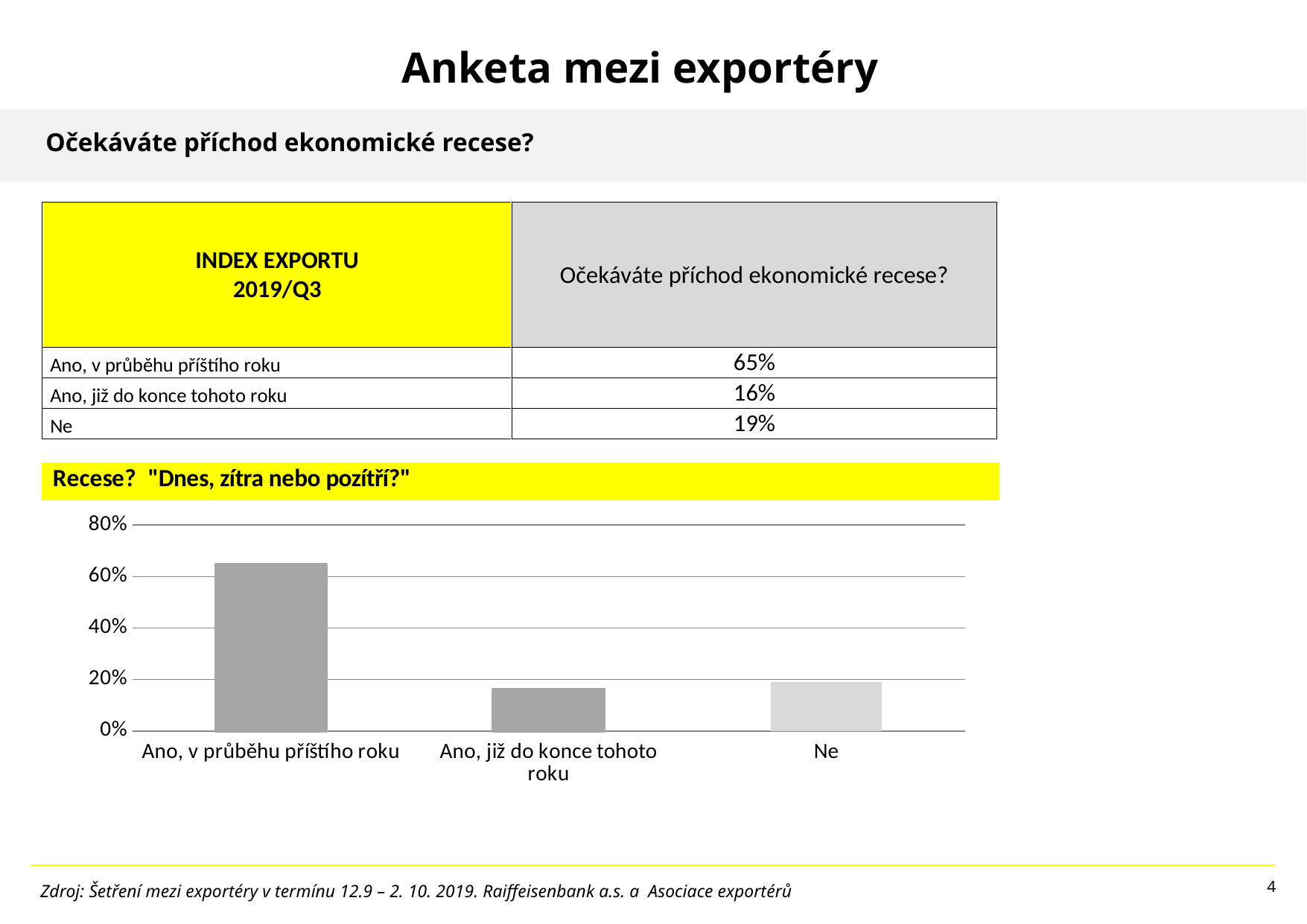
What is the value for "Ne"? 19% What is the difference between the values for "Ano, v průběhu příštího roku" and "Ne"? 46% Which category has the lowest bar in the chart? Ano, již do konce tohoto roku Which category has the highest bar in the chart? Ano, v průběhu příštího roku Is the bar for "Ano, v průběhu příštího roku" greater or less than 60%? greater What is the value for "Ano, v průběhu příštího roku"? 65% What is the value for "Ano, již do konce tohoto roku"? 16% Which is larger, the value for "Ne" or the value for "Ano, již do konce tohoto roku"? Ne How many categories are shown on the x axis of the bar chart? 3 What is the title of the bar chart? Recese? "Dnes, zítra nebo pozítří?" Is the bar for "Ne" greater or less than 20%? less What type of chart is shown on the slide? bar chart